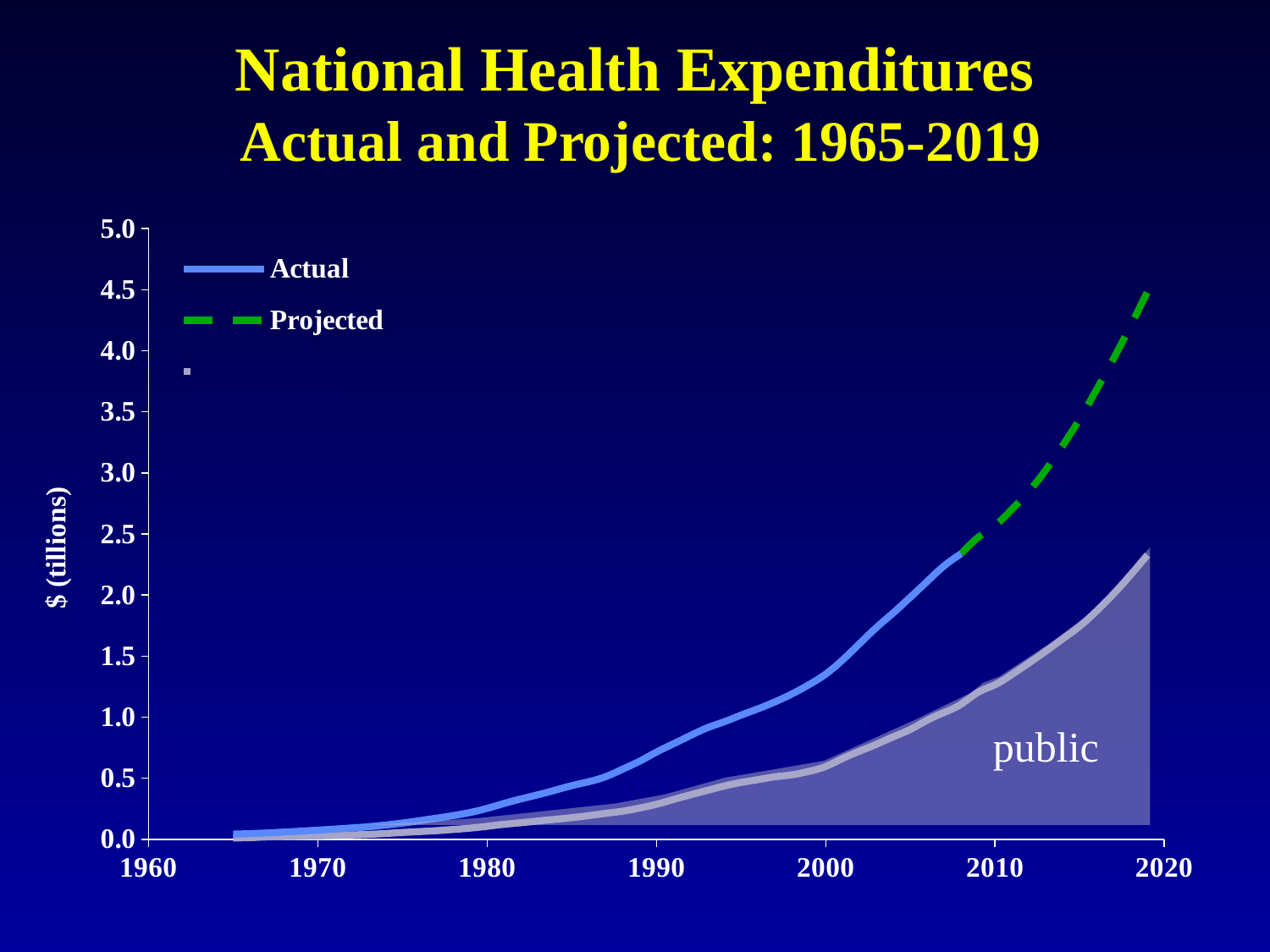
What are the two series named in the legend? Actual and Projected Do the Actual expenditures rise or fall from 1965 to 2008? rise Is the public value in 2000 greater or less than 1.0? less What kind of chart is shown on the slide? line chart Is the Projected value in 2019 greater or less than 4.0? greater Is the Actual value in 2000 greater or less than 1.5? less What is the title of the chart? National Health Expenditures Actual and Projected: 1965-2019 How many series does the legend list by name? 2 In 2000, which is larger: the Actual total or the public portion? Actual